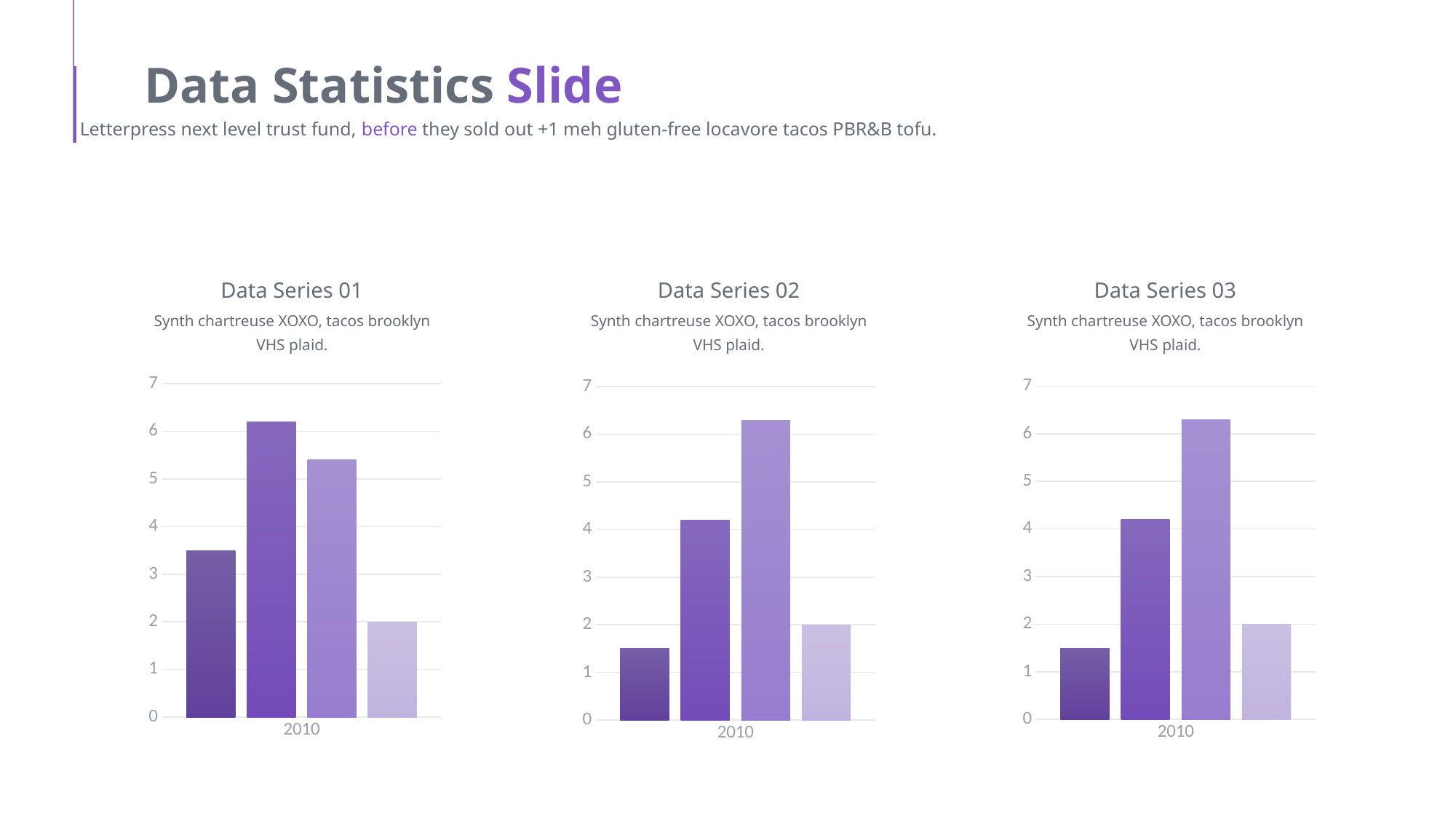
In the "Data Series 01" chart, which bar is the shortest: the first, second, third or fourth from the left? fourth In the "Data Series 01" chart, is the value of the third bar from the left greater or less than 6? less What category label appears on the x axis of the "Data Series 03" chart? 2010 How many bars are plotted in the "Data Series 01" chart? 4 In the "Data Series 02" chart, which bar is the tallest: the first, second, third or fourth from the left? third In the "Data Series 01" chart, which bar is the tallest: the first, second, third or fourth from the left? second In the "Data Series 01" chart, is the value of the first (leftmost) bar greater or less than 3? greater In the "Data Series 02" chart, which bar is the shortest: the first, second, third or fourth from the left? first In the "Data Series 03" chart, which is larger: the second bar from the left or the fourth bar from the left? second bar In the "Data Series 03" chart, is the value of the first (leftmost) bar greater or less than 2? less What kind of chart is shown under the title "Data Series 01"? bar chart